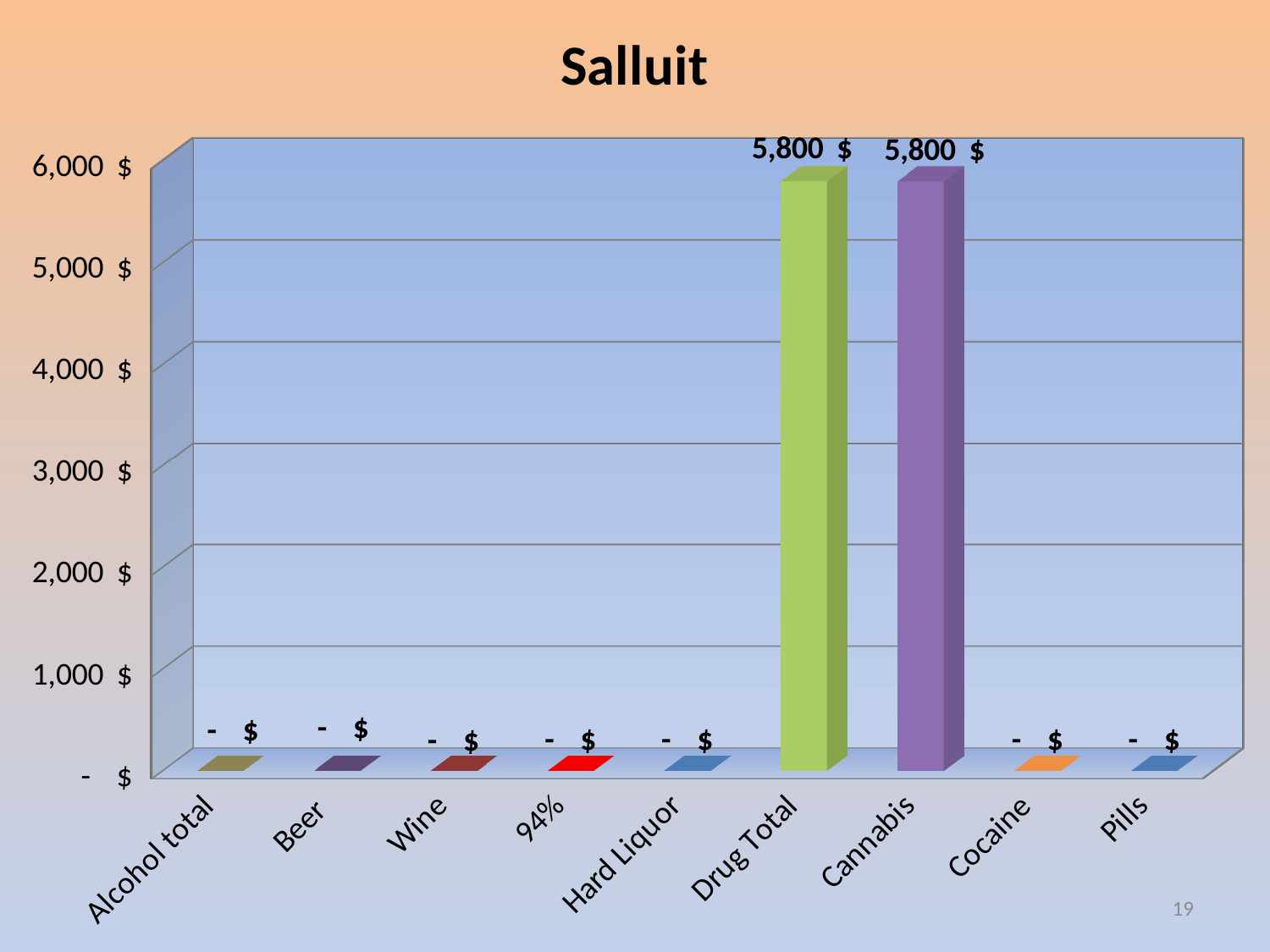
Which is larger, the value for Cannabis or the value for Pills? Cannabis What is the data label shown for Cocaine? - $ What is the value for Cannabis? 5,800 $ What kind of chart is shown on the slide? Bar chart What is the title of the chart? Salluit What is the value for Drug Total? 5,800 $ Is the value for Cannabis greater or less than 6,000 $? less How many categories are shown on the x axis? 9 What is the difference between the values for Drug Total and Cannabis? 0 $ What is the data label shown for Beer? - $ What is the highest value shown on the vertical axis? 6,000 $ Is the value for Drug Total greater or less than 5,000 $? greater